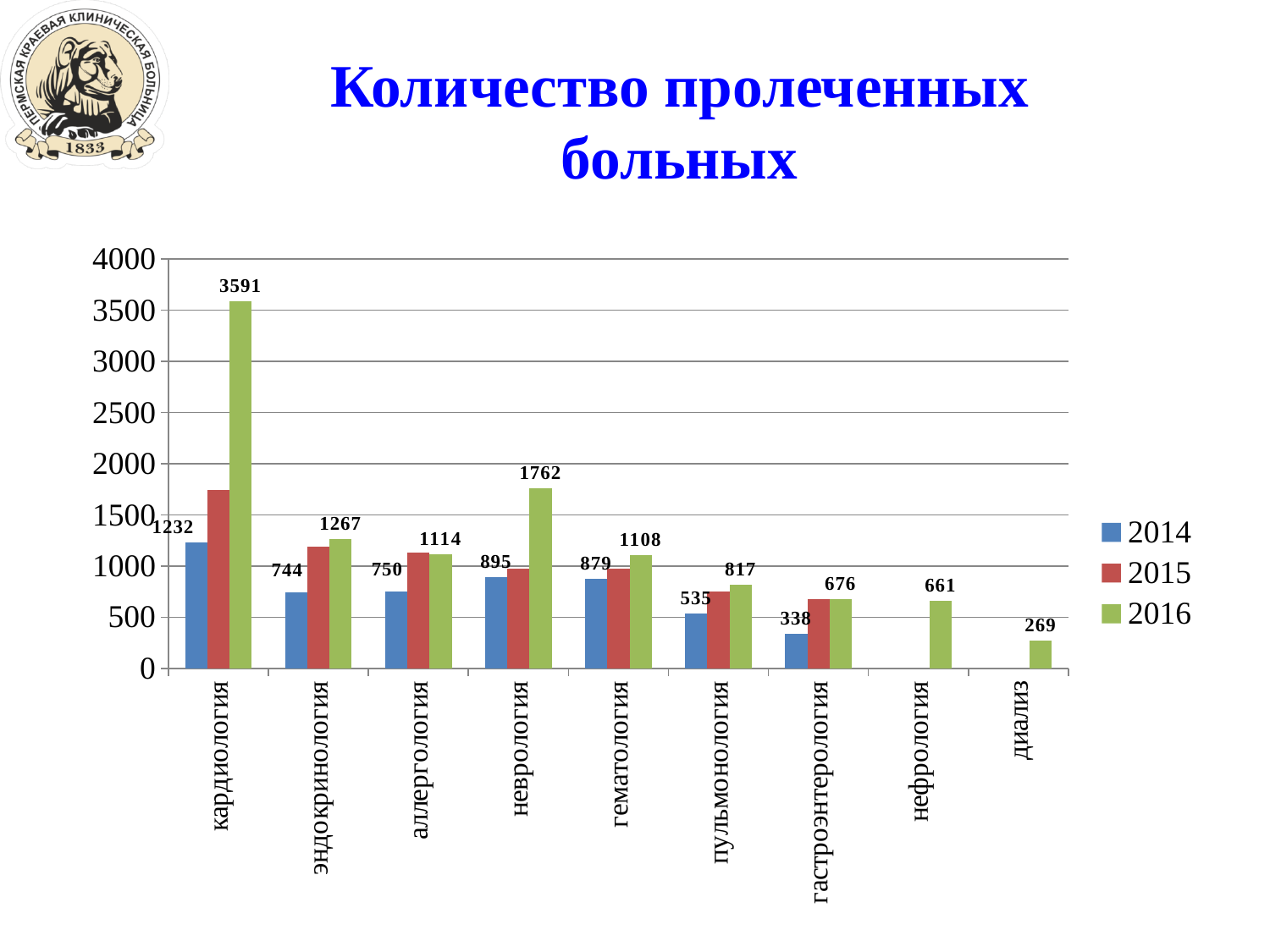
What is the title of the chart? Количество пролеченных больных What kind of chart is shown on the slide? bar chart What is the value for кардиология in the 2016 series? 3591 What is the value for неврология in the 2014 series? 895 What is the value for диализ in the 2016 series? 269 What is the difference between the 2016 and 2014 values for кардиология? 2359 Which category has the highest value in the 2016 series? кардиология How many series does the legend list? 3 Which is larger for аллергология: the 2014 value or the 2016 value? 2016 Which category has the lowest value in the 2014 series among those with a 2014 bar? гастроэнтерология How many categories are shown on the x axis? 9 Is the 2015 value for кардиология greater or less than 1500? greater